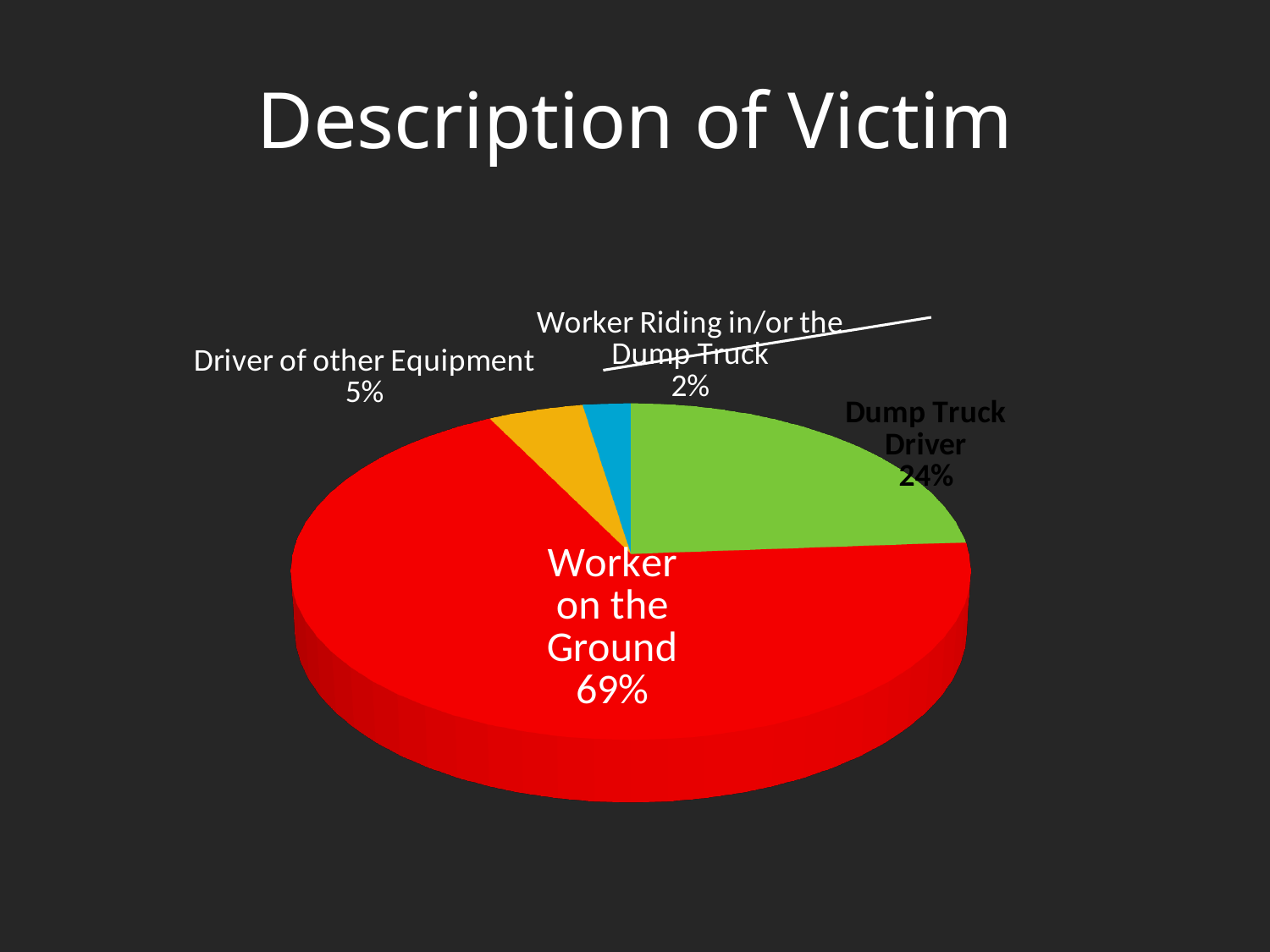
What colour is the Dump Truck Driver slice? Green Which is larger, the share for Driver of other Equipment or the share for Worker Riding in/or the Dump Truck? Driver of other Equipment What is the title of the chart? Description of Victim What share of the pie does Worker on the Ground represent? 69% How many categories are shown in the pie chart? 4 What percentage is shown for Driver of other Equipment? 5% Which category has the largest share of the pie? Worker on the Ground What percentage is shown for Dump Truck Driver? 24% What kind of chart is shown on the slide? Pie chart What is the difference in percentage points between Worker on the Ground and Dump Truck Driver? 45 What percentage is shown for Worker Riding in/or the Dump Truck? 2% Which category has the smallest share of the pie? Worker Riding in/or the Dump Truck